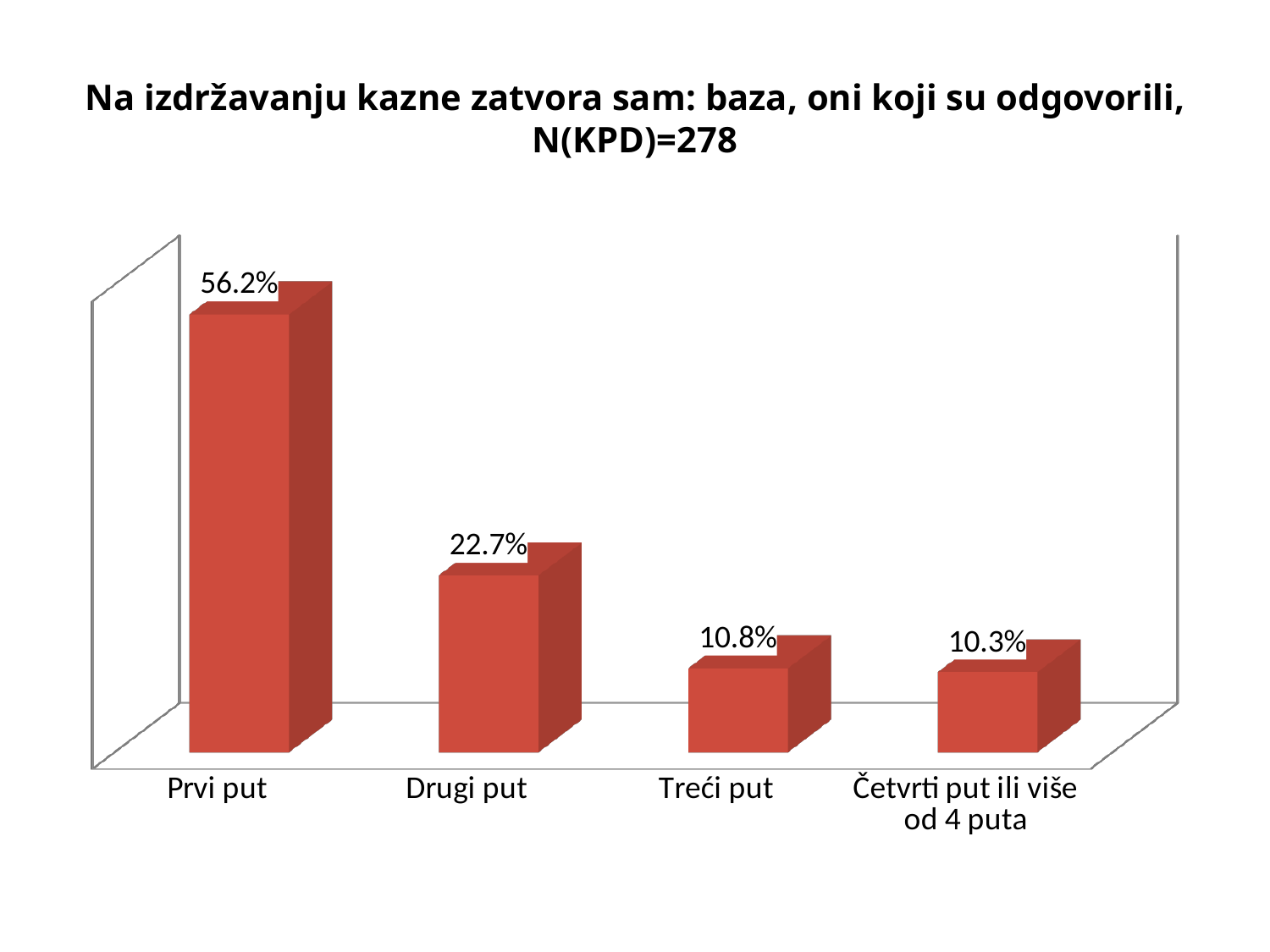
What is the difference between the values for Prvi put and Drugi put? 33.5% What is the value for Četvrti put ili više od 4 puta? 10.3% What is the value for Treći put? 10.8% Which is larger, the value for Drugi put or the value for Treći put? Drugi put What is the difference between the values for Treći put and Četvrti put ili više od 4 puta? 0.5% What is the value for Drugi put? 22.7% What kind of chart is shown on the slide? Bar chart Which category has the highest value? Prvi put How many categories are shown on the chart? 4 Which category has the lowest value? Četvrti put ili više od 4 puta Do the values rise or fall from left to right along the x axis? Fall What is the value for Prvi put? 56.2%